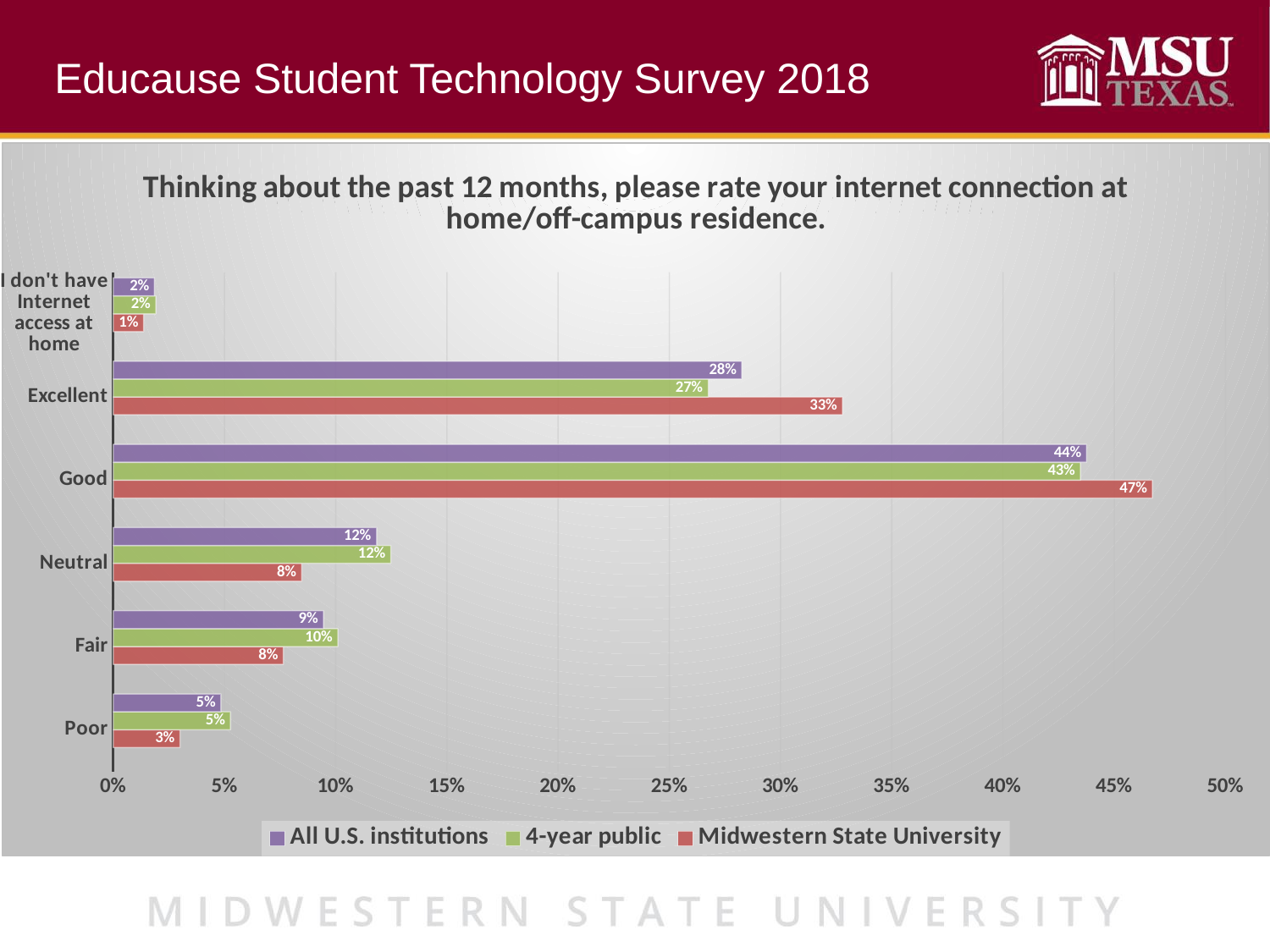
What kind of chart is shown on the slide? Bar chart What is the value for Midwestern State University in the Good category? 47% What is the value for All U.S. institutions in the Excellent category? 28% In the Neutral category, which is larger: All U.S. institutions or Midwestern State University? All U.S. institutions What is the value for 4-year public in the Fair category? 10% Is the value for 4-year public in the Good category greater or less than 40%? greater Which series is shown in red in the legend? Midwestern State University Which category has the highest value for Midwestern State University? Good What is the difference between Midwestern State University and All U.S. institutions in the Excellent category? 5% How many categories are shown on the chart? 6 How many series does the legend list? 3 Which category has the lowest value for Midwestern State University? I don't have Internet access at home